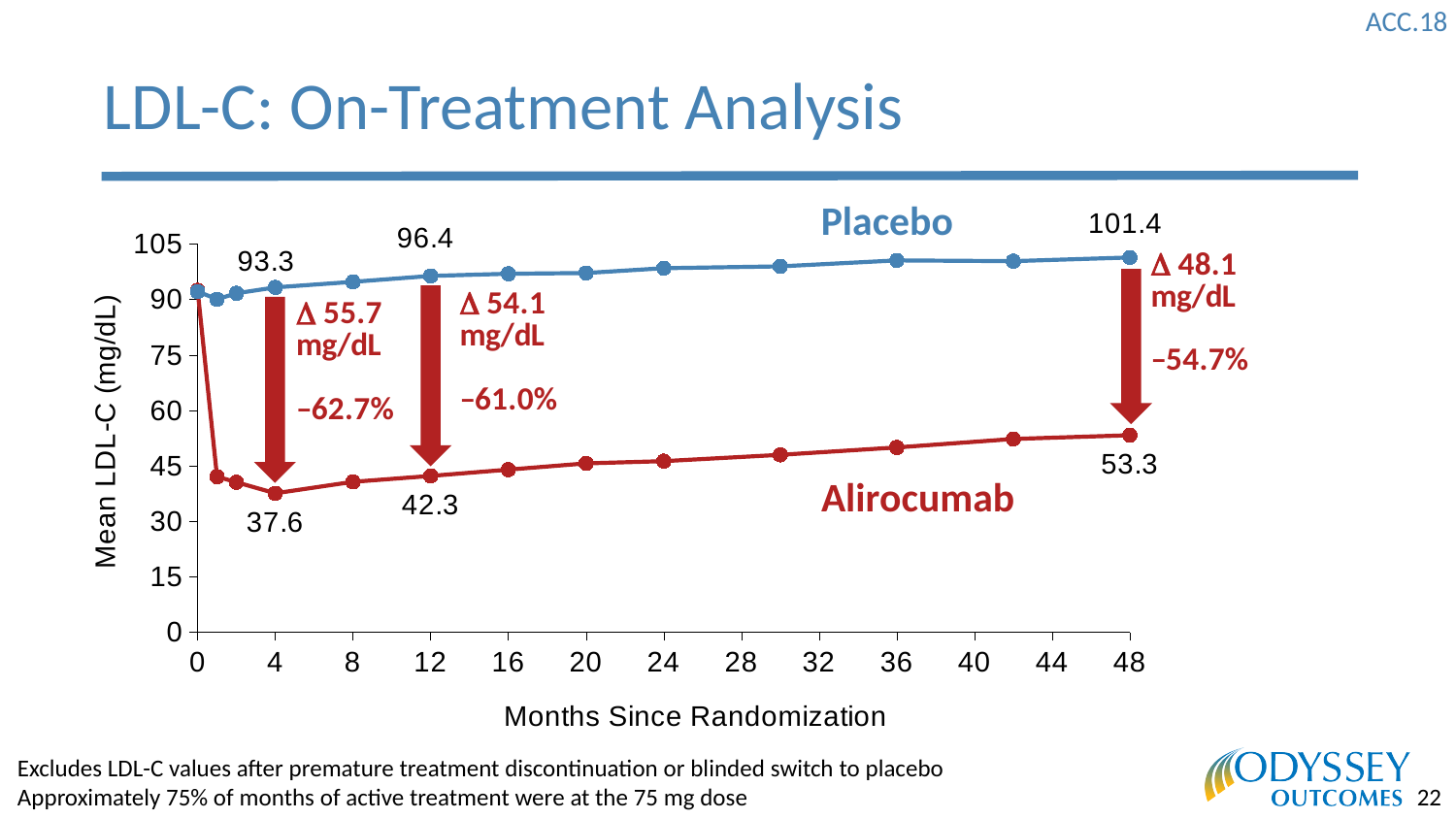
What is the label of the y axis? Mean LDL-C (mg/dL) What is the difference between the Placebo and Alirocumab mean LDL-C values at 12 months? 54.1 mg/dL What is the difference between the Placebo and Alirocumab mean LDL-C values at 48 months? 48.1 mg/dL What is the mean LDL-C for Alirocumab at 12 months since randomization? 42.3 What kind of chart is shown on the slide? line chart Does the Alirocumab line rise or fall between 4 and 48 months since randomization? rise What is the mean LDL-C for Placebo at 48 months since randomization? 101.4 Is the Placebo value at 36 months greater or less than 90? greater Which series has the higher mean LDL-C at 48 months, Placebo or Alirocumab? Placebo What is the mean LDL-C for Alirocumab at 4 months since randomization? 37.6 What is the mean LDL-C for Placebo at 4 months since randomization? 93.3 Is the Alirocumab value at 24 months greater or less than 60? less